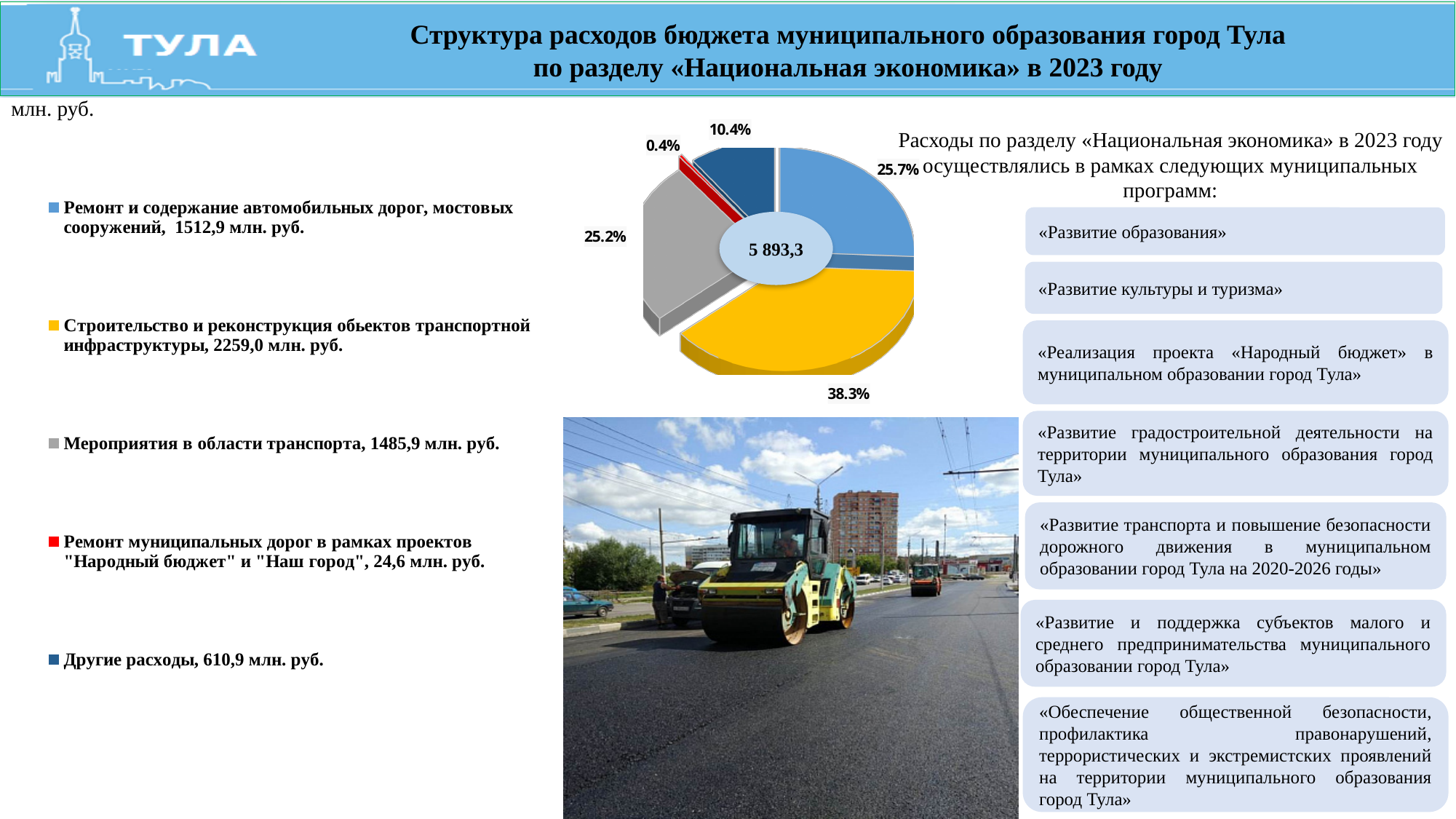
What kind of chart is shown on the slide? pie chart What is the value in млн. руб. for «Мероприятия в области транспорта» according to the legend? 1485,9 млн. руб. Which category has the largest slice of the pie? Строительство и реконструкция объектов транспортной инфраструктуры How many categories does the pie chart have? 5 What share of the pie does «Мероприятия в области транспорта» have? 25.2% What total value is shown in the centre of the pie chart? 5 893,3 Which category has the smallest slice of the pie? Ремонт муниципальных дорог в рамках проектов "Народный бюджет" и "Наш город" What is the value in млн. руб. for «Другие расходы» according to the legend? 610,9 млн. руб. What share of the pie does «Строительство и реконструкция объектов транспортной инфраструктуры» have? 38.3% What share of the pie does «Ремонт и содержание автомобильных дорог, мостовых сооружений» have? 25.7%